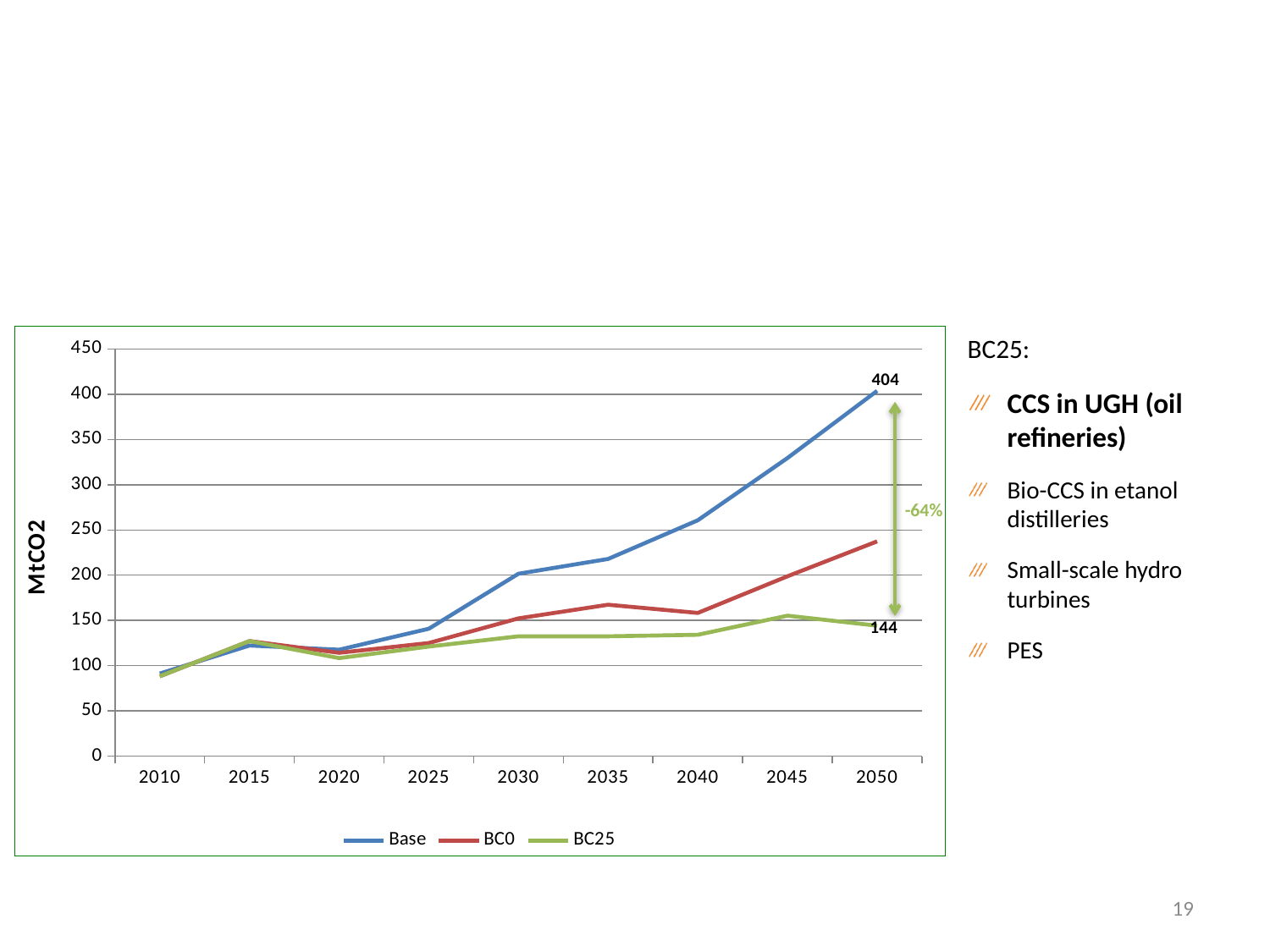
Which series has the highest value in 2050? Base How many years are shown on the x axis? 9 Is the value for BC25 in 2040 greater or less than 150? less Is the value for BC0 in 2050 greater or less than 200? greater What is the value of the Base series in 2050? 404 What is the value of the BC25 series in 2050? 144 Does the Base series rise or fall from 2010 to 2050? rise What is the label on the y axis of the chart? MtCO2 What is the difference between the Base and BC25 values in 2050? 260 In 2050, which is larger: the Base value or the BC0 value? Base What kind of chart is shown on the slide? line chart How many series does the legend list? 3